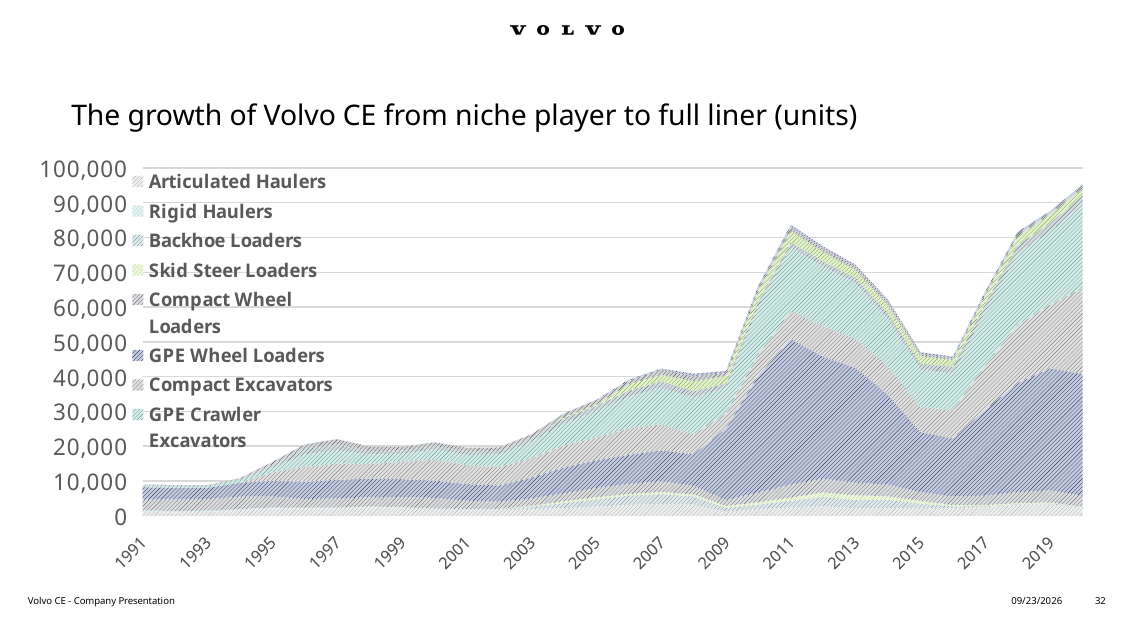
How many year labels are shown on the x axis? 15 What kind of chart is shown on the slide? Stacked area chart Which series is listed first in the legend? Articulated Haulers Is the total number of units in 2015 greater or less than 50,000? less What is the title of the chart? The growth of Volvo CE from niche player to full liner (units) Is the total number of units in 2011 greater or less than 70,000? greater Is the total number of units in 2019 greater or less than 80,000? greater How many series does the legend list? 8 Overall, do total units rise or fall from 1991 to 2019? rise Which is larger, the total units in 2011 or in 2015? 2011